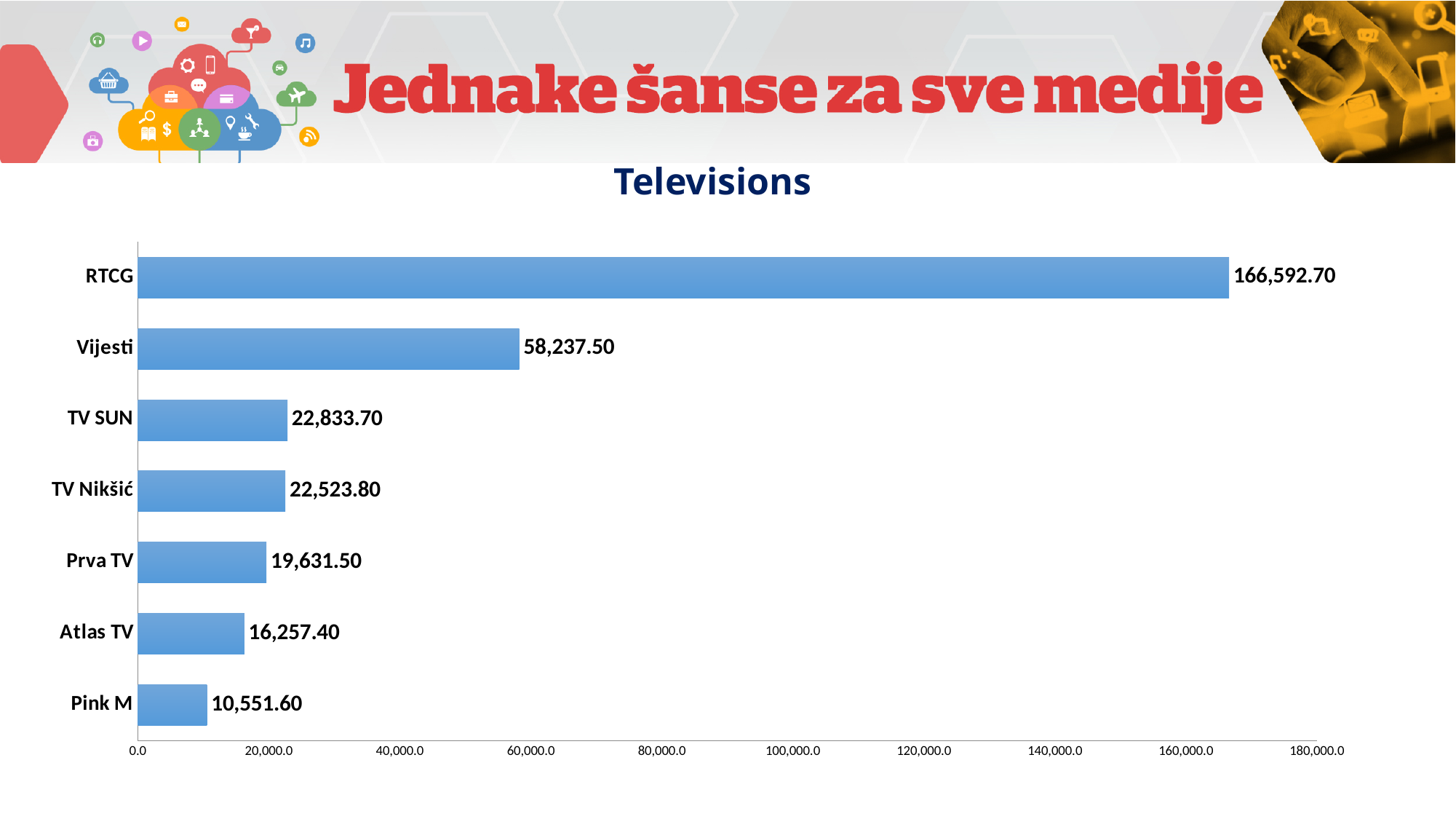
What is the value for Prva TV? 19,631.50 Which television has the lowest value? Pink M What is the difference between the values for Atlas TV and Pink M? 5,705.80 What is the value for RTCG? 166,592.70 How many televisions are shown in the chart? 7 What is the difference between the values for RTCG and Vijesti? 108,355.20 Is the value for Vijesti greater or less than 40,000.0? greater What is the value for Pink M? 10,551.60 What is the value for Vijesti? 58,237.50 Which television has the highest value? RTCG Which has a larger value, Prva TV or Atlas TV? Prva TV What kind of chart is shown on the slide? bar chart